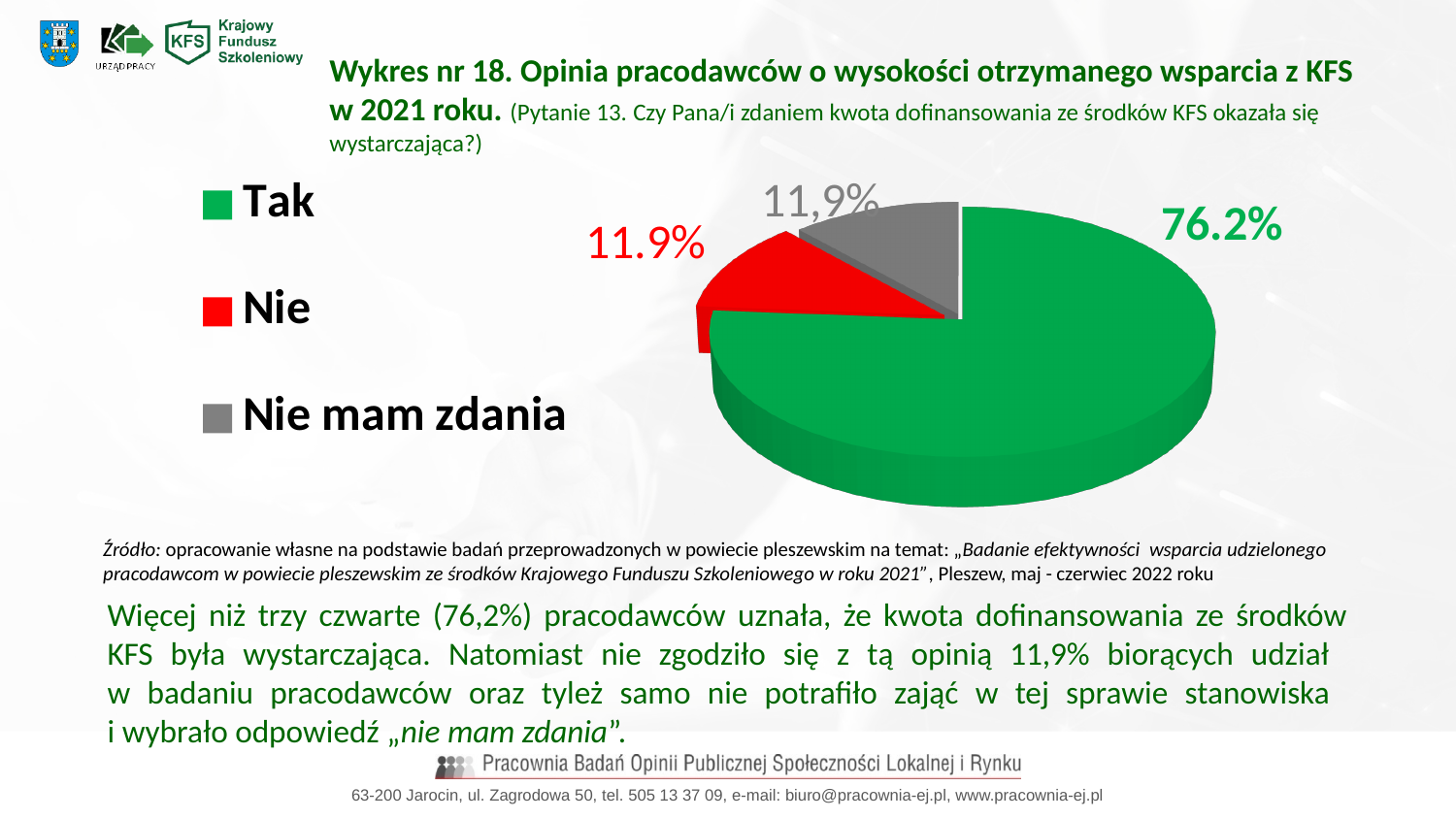
How many slices does the pie chart have? 3 How many entries does the legend list? 3 What percentage of employers answered "Nie mam zdania"? 11,9% What is the difference between the share for "Tak" and the share for "Nie"? 64.3% Which is larger, the share for "Tak" or the share for "Nie mam zdania"? Tak What percentage of employers answered "Tak"? 76.2% What share of the pie does the "Tak" slice represent? 76.2% Which answer has the largest share of the pie? Tak What kind of chart is shown on the slide? pie chart What colour is the "Nie" slice in the pie chart? red What colour is the "Nie mam zdania" slice in the pie chart? grey What percentage of employers answered "Nie"? 11.9%